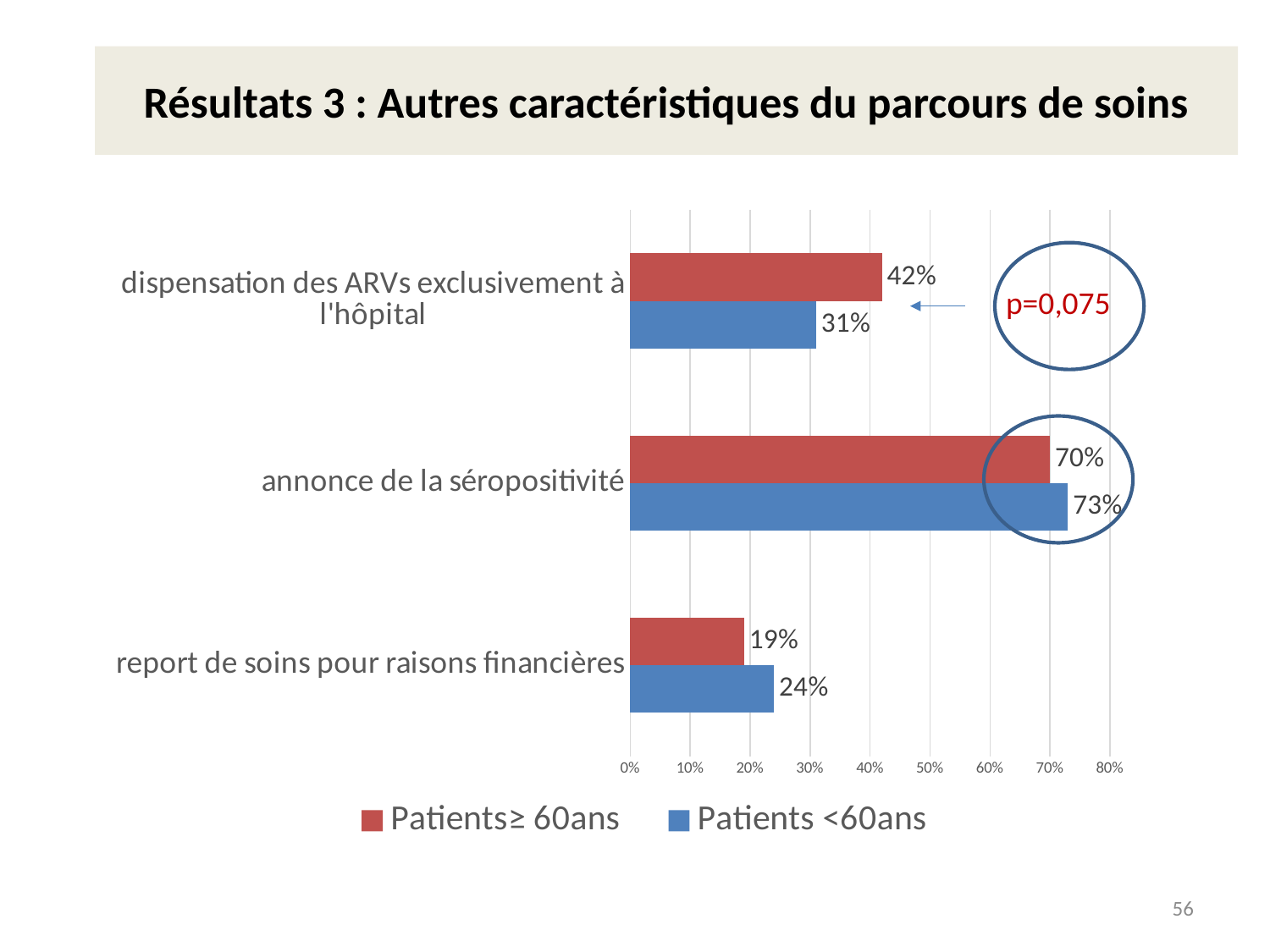
Which category has the lowest value for 'Patients <60ans'? report de soins pour raisons financières In the category 'report de soins pour raisons financières', which series has the larger value, 'Patients≥ 60ans' or 'Patients <60ans'? Patients <60ans What is the value for 'Patients <60ans' in the category 'report de soins pour raisons financières'? 24% What is the value for 'Patients≥ 60ans' in the category 'dispensation des ARVs exclusivement à l'hôpital'? 42% How many categories are shown on the chart? 3 Is the value for 'Patients≥ 60ans' in 'annonce de la séropositivité' greater or less than 50%? greater Which category has the highest value for 'Patients≥ 60ans'? annonce de la séropositivité What is the value for 'Patients <60ans' in the category 'annonce de la séropositivité'? 73% How many series does the legend list? 2 What kind of chart is shown on the slide? bar chart What p-value is shown in the circle next to the 'dispensation des ARVs exclusivement à l'hôpital' bars? p=0,075 What is the difference between 'Patients≥ 60ans' and 'Patients <60ans' in the category 'dispensation des ARVs exclusivement à l'hôpital'? 11%